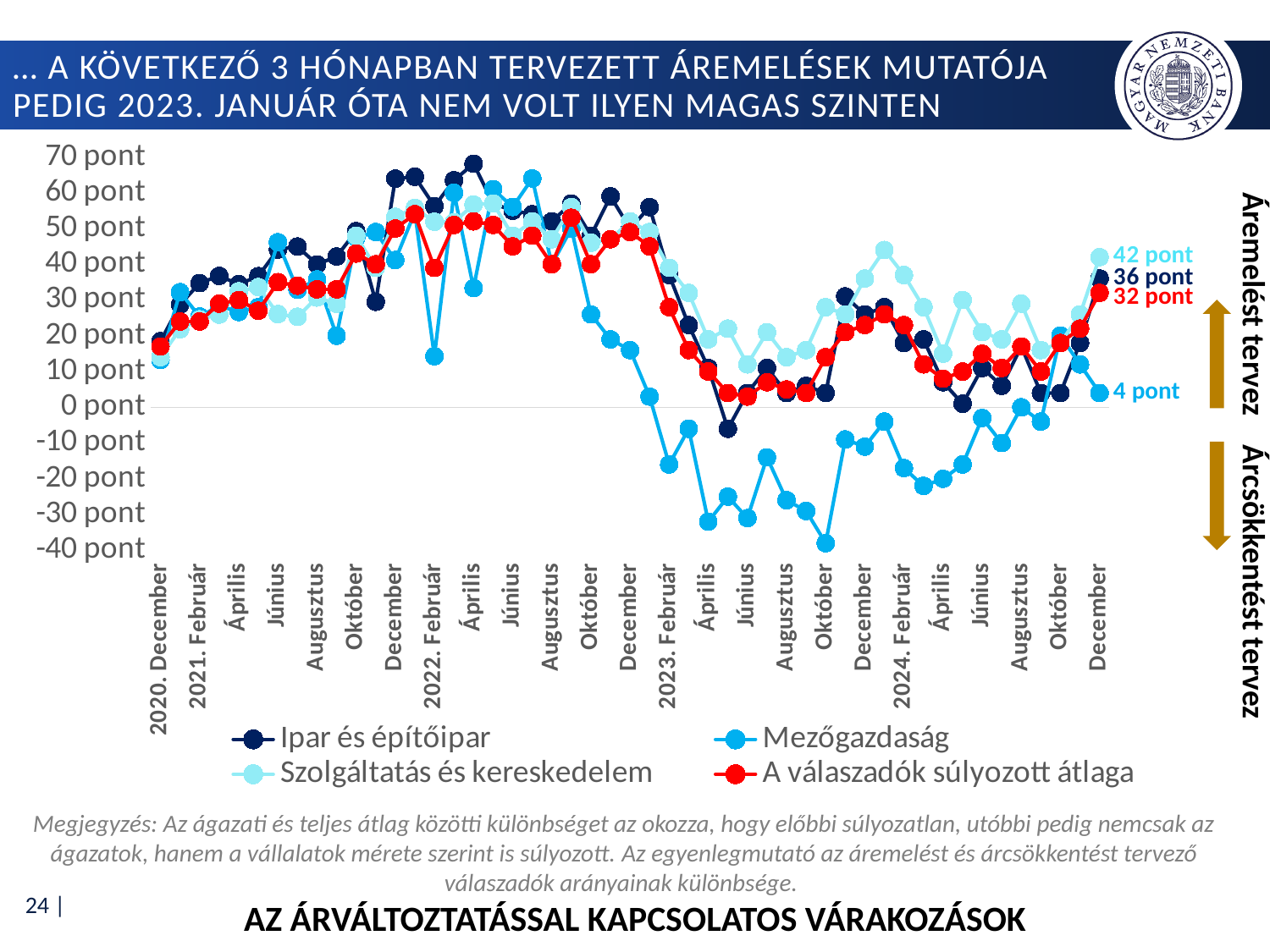
At the last point, which is larger: Ipar és építőipar or A válaszadók súlyozott átlaga? Ipar és építőipar Which series has the lowest value at the last point (2024 December)? Mezőgazdaság How many series does the legend list? 4 Is the value for Mezőgazdaság in 2023 Április greater or less than -20 pont? less What colour is the line for A válaszadók súlyozott átlaga? red What kind of chart is shown on the slide? line chart What is the value for A válaszadók súlyozott átlaga at the last point (2024 December)? 32 pont What is the difference between the final values of Szolgáltatás és kereskedelem and Mezőgazdaság? 38 pont What is the value for Mezőgazdaság at the last point (2024 December)? 4 pont What is the value for Szolgáltatás és kereskedelem at the last point (2024 December)? 42 pont Which series has the highest value at the last point (2024 December)? Szolgáltatás és kereskedelem What is the value for Ipar és építőipar at the last point (2024 December)? 36 pont